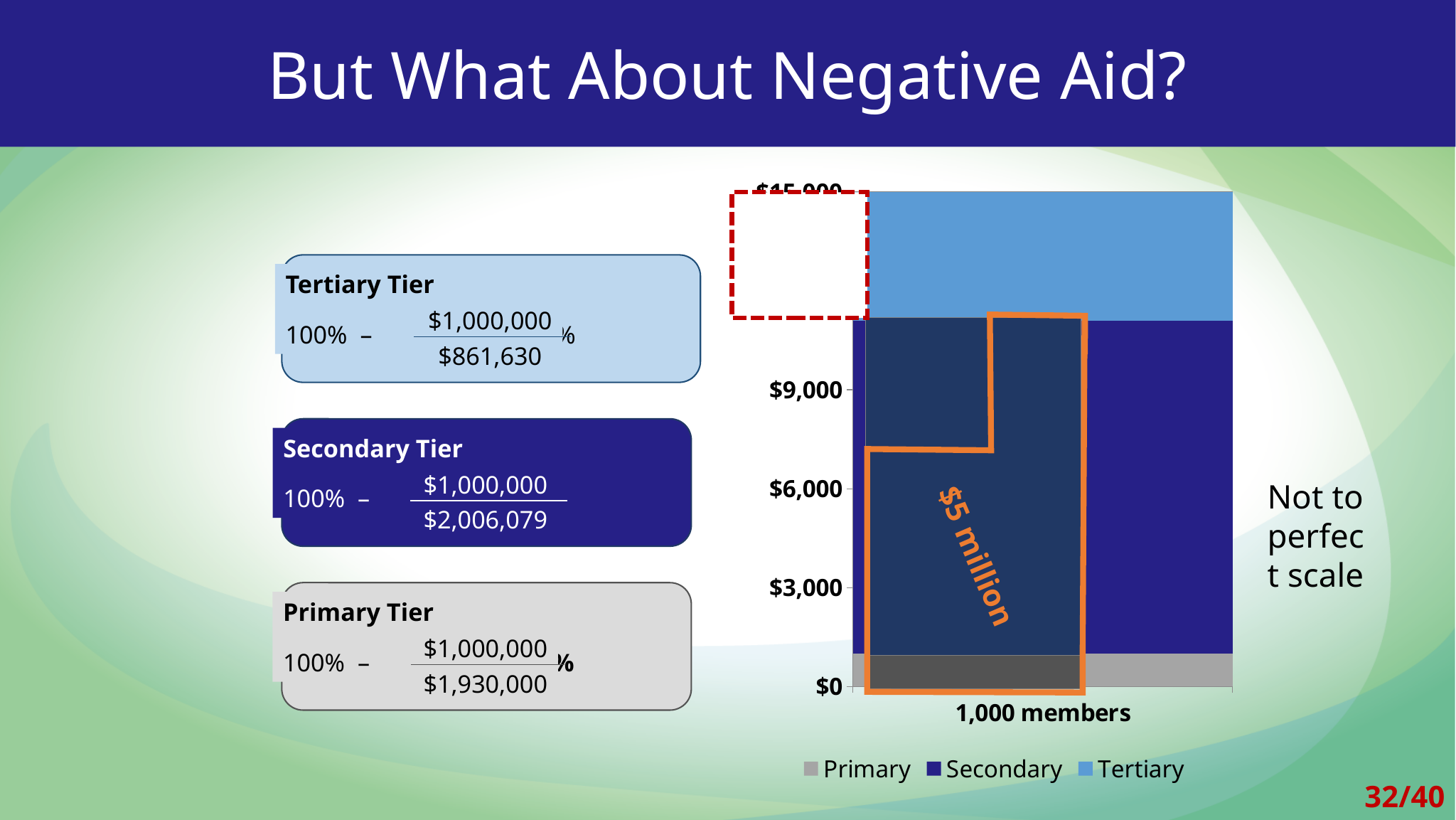
How many categories are plotted on the x axis of the chart? 1 What is the label of the single category on the chart's x axis? 1,000 members How many series does the chart's legend list? 3 Which segment of the stacked bar is the largest: Primary, Secondary or Tertiary? Secondary Is the top of the Primary segment of the bar greater or less than $3,000? less What kind of chart is shown on the slide? Stacked bar chart Is the top of the Secondary segment of the bar greater or less than $9,000? greater Which series is shown at the bottom of the stacked bar? Primary Is the top of the Secondary segment of the bar greater or less than $6,000? greater Which segment of the stacked bar is the smallest: Primary, Secondary or Tertiary? Primary Is the Secondary segment of the bar larger or smaller than the Tertiary segment? larger